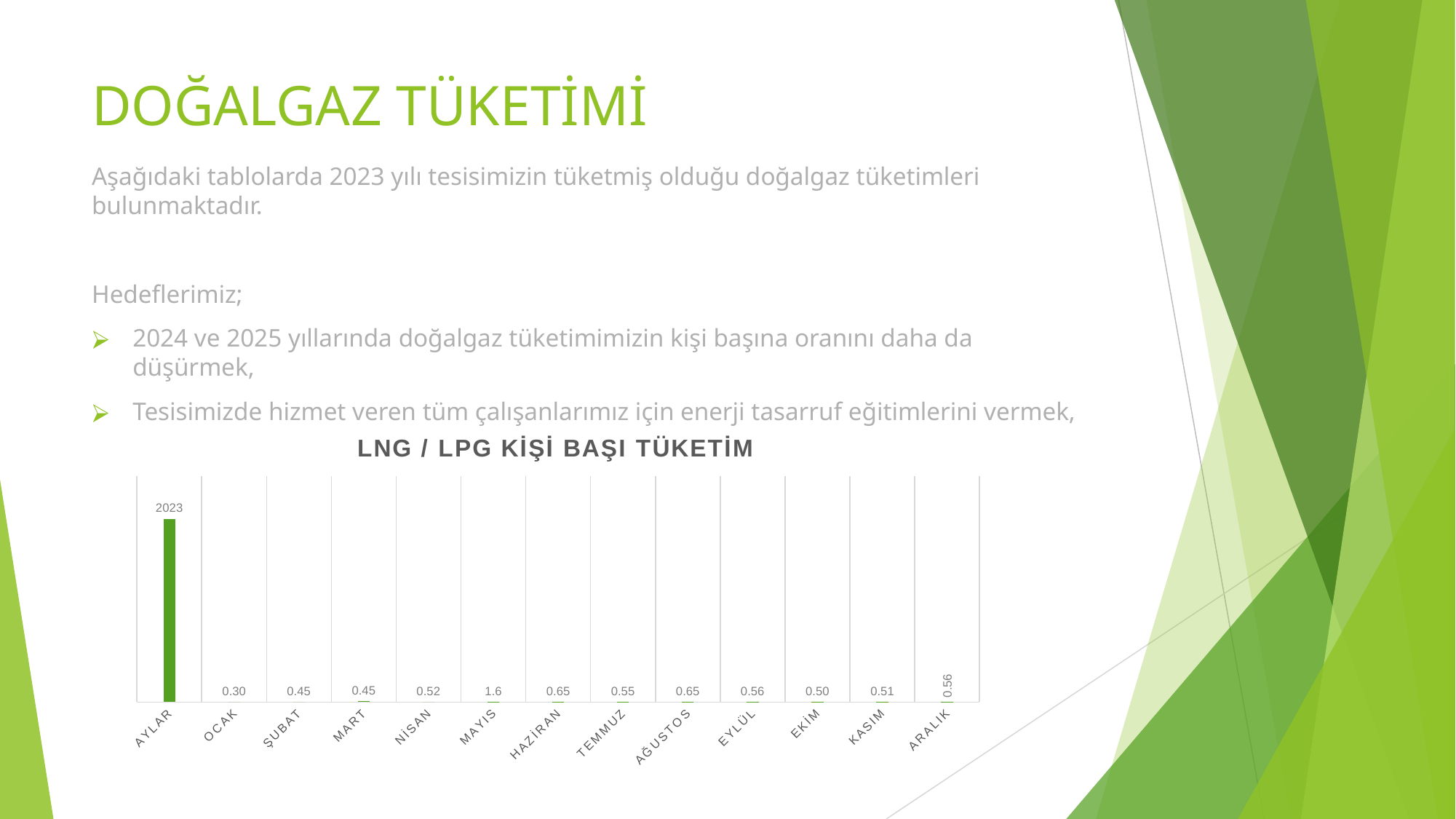
What is the value for KASIM in the LNG / LPG KİŞİ BAŞI TÜKETİM chart? 0.51 Among the months OCAK through ARALIK, which has the highest value in the LNG / LPG KİŞİ BAŞI TÜKETİM chart? MAYIS Which category has the lowest value in the LNG / LPG KİŞİ BAŞI TÜKETİM chart? OCAK Which is larger in the LNG / LPG KİŞİ BAŞI TÜKETİM chart, the value for NİSAN or the value for EKİM? NİSAN How many categories are shown on the x axis of the LNG / LPG KİŞİ BAŞI TÜKETİM chart? 13 What value is labelled on the AYLAR bar in the LNG / LPG KİŞİ BAŞI TÜKETİM chart? 2023 What is the difference between the values for HAZİRAN and OCAK in the LNG / LPG KİŞİ BAŞI TÜKETİM chart? 0.35 What is the value for MAYIS in the LNG / LPG KİŞİ BAŞI TÜKETİM chart? 1.6 What is the title of the chart on the slide? LNG / LPG KİŞİ BAŞI TÜKETİM What is the value for OCAK in the LNG / LPG KİŞİ BAŞI TÜKETİM chart? 0.30 What is the value for EYLÜL in the LNG / LPG KİŞİ BAŞI TÜKETİM chart? 0.56 What kind of chart is the LNG / LPG KİŞİ BAŞI TÜKETİM chart? Bar chart